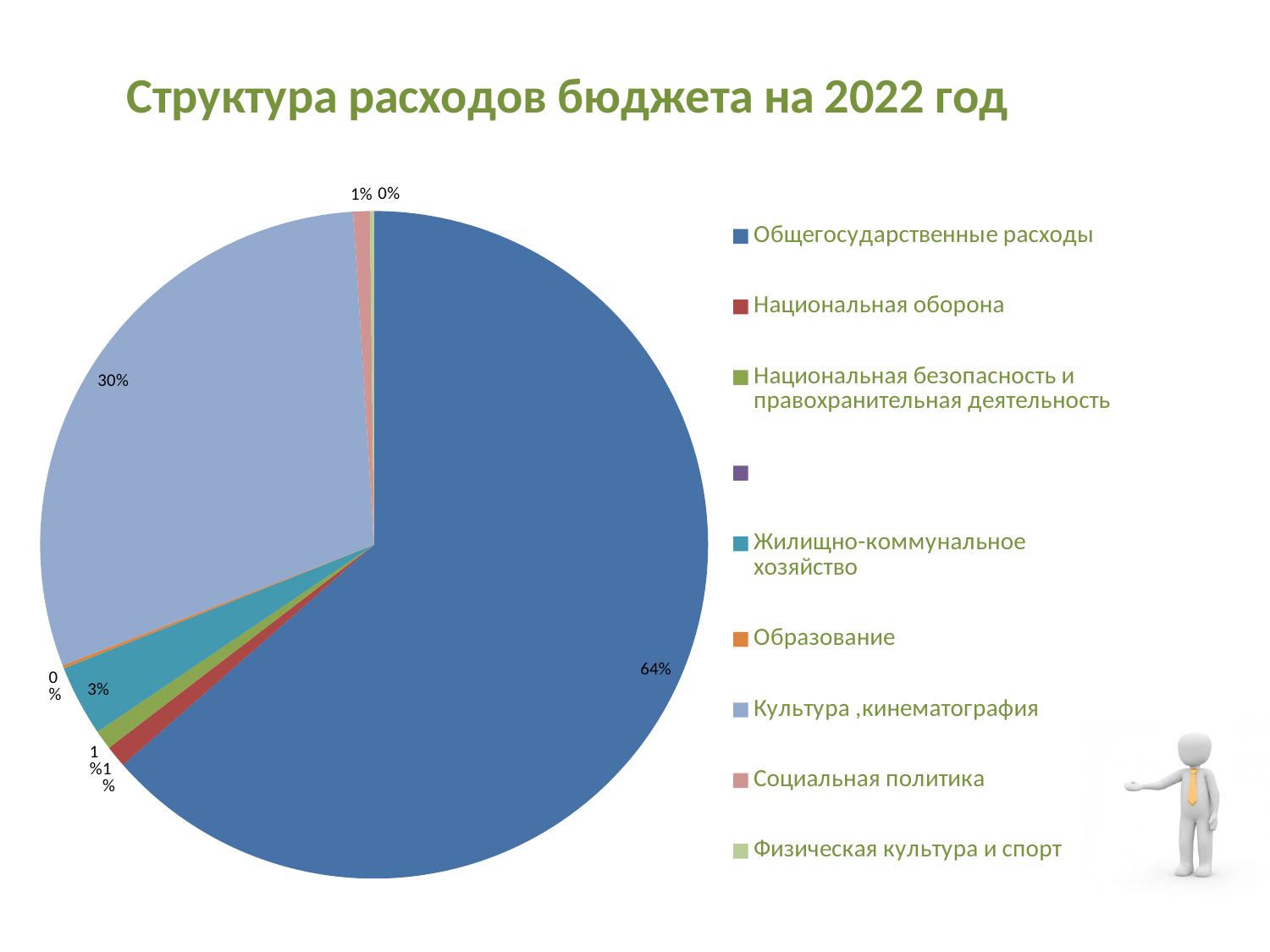
What is the difference between the shares of Культура ,кинематография and Жилищно-коммунальное хозяйство? 27 percentage points What is the value shown for Жилищно-коммунальное хозяйство? 3% What is the difference between the shares of Общегосударственные расходы and Культура ,кинематография? 34 percentage points What is the title of the slide's chart? Структура расходов бюджета на 2022 год What share of the pie does Общегосударственные расходы take? 64% What is the value shown for Образование? 0% Which is larger: the share for Культура ,кинематография or the share for Жилищно-коммунальное хозяйство? Культура ,кинематография What kind of chart is shown on the slide? pie chart What colour is the slice for Общегосударственные расходы? blue What is the value shown for Культура ,кинематография? 30% What is the value shown for Социальная политика? 1% Which category has the largest slice of the pie? Общегосударственные расходы